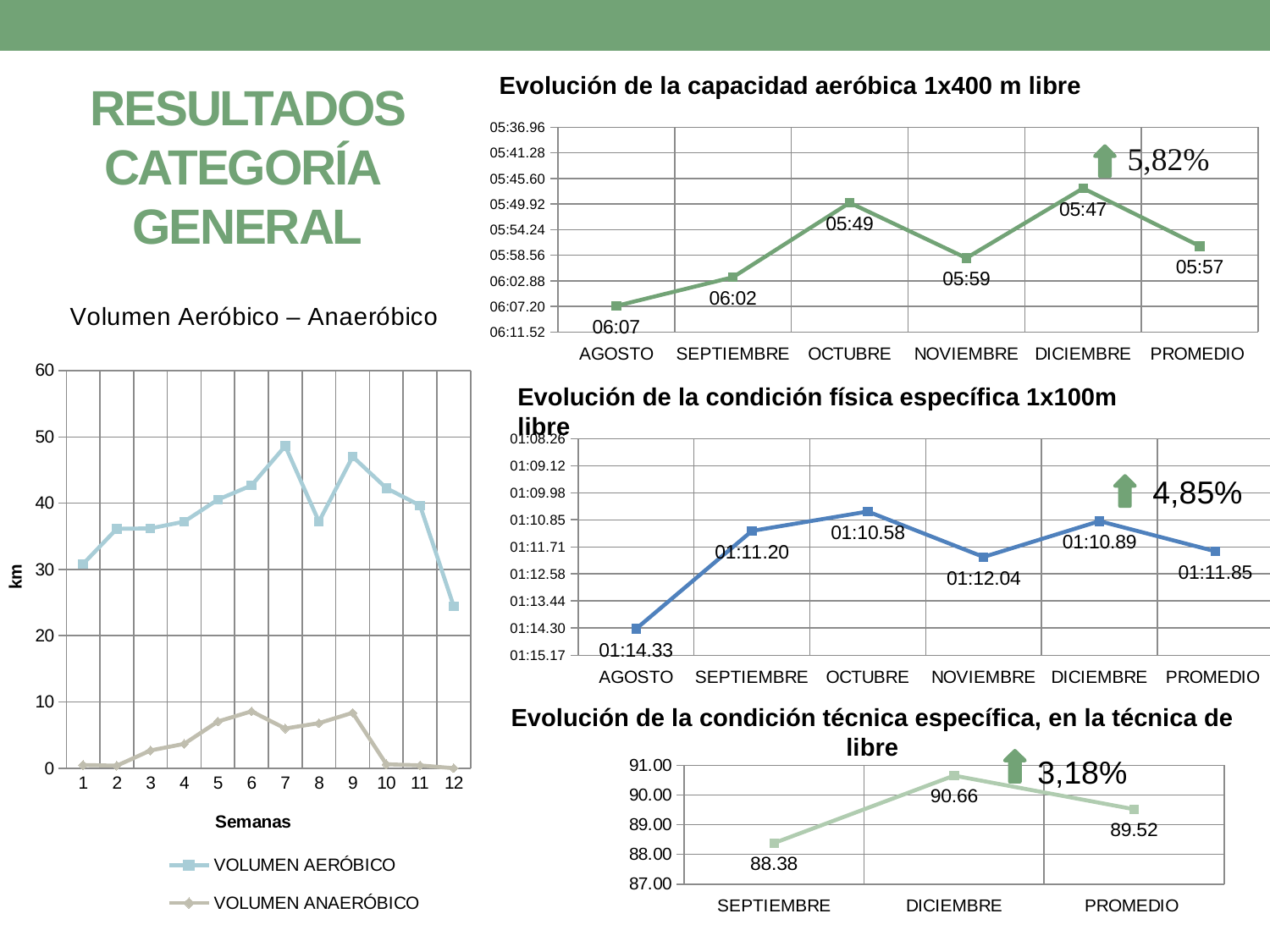
In the chart 'Evolución de la condición física específica 1x100m libre', what is the value for PROMEDIO? 01:11.85 In the chart 'Evolución de la capacidad aeróbica 1x400 m libre', which category has the largest time value? AGOSTO In the 'Volumen Aeróbico – Anaeróbico' chart, is the VOLUMEN AERÓBICO value at week 7 greater or less than 40? greater In the chart 'Evolución de la condición técnica específica, en la técnica de libre', what is the value for SEPTIEMBRE? 88.38 In the chart 'Evolución de la condición física específica 1x100m libre', which category has the smallest time value? OCTUBRE How many categories are shown on the x axis of the chart 'Evolución de la condición técnica específica, en la técnica de libre'? 3 How many series does the legend of the 'Volumen Aeróbico – Anaeróbico' chart list? 2 What kind of chart is the 'Volumen Aeróbico – Anaeróbico' chart? line chart In the chart 'Evolución de la condición física específica 1x100m libre', what is the value for NOVIEMBRE? 01:12.04 In the chart 'Evolución de la condición técnica específica, en la técnica de libre', what is the difference between the DICIEMBRE and SEPTIEMBRE values? 2.28 In the chart 'Evolución de la capacidad aeróbica 1x400 m libre', what is the value for OCTUBRE? 05:49 In the chart 'Evolución de la capacidad aeróbica 1x400 m libre', which month has the smallest time value? DICIEMBRE